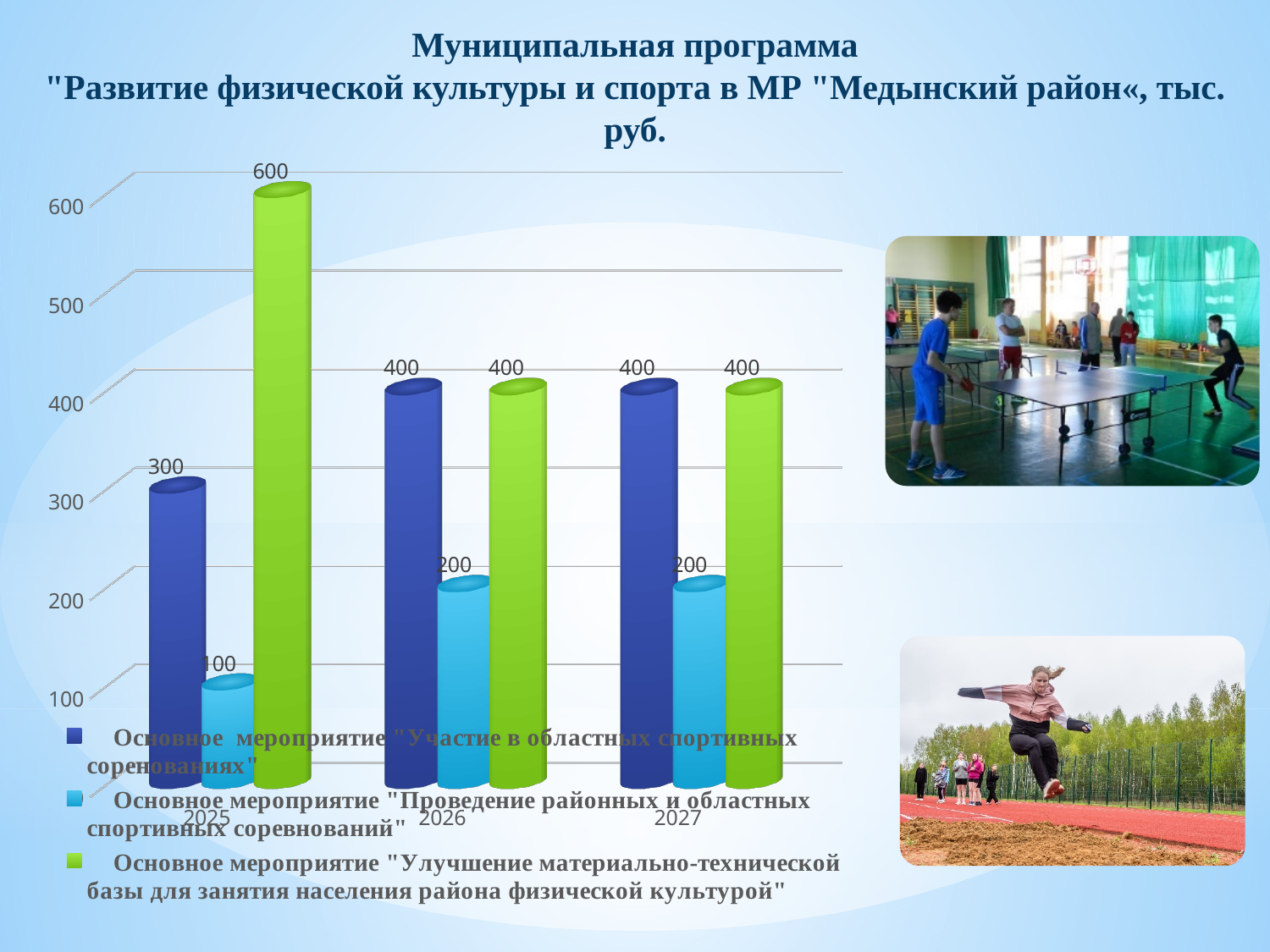
What is the value for 2025 for the series "Улучшение материально-технической базы для занятия населения района физической культурой"? 600 Which year has the highest value for the series "Улучшение материально-технической базы для занятия населения района физической культурой"? 2025 What is the value for 2027 for the series "Участие в областных спортивных соревнованиях"? 400 Which year has the lowest value for the series "Проведение районных и областных спортивных соревнований"? 2025 How many years are shown on the x axis of the chart? 3 What is the difference between the 2025 values of the series "Улучшение материально-технической базы..." and "Участие в областных спортивных соревнованиях"? 300 Does the value for the series "Участие в областных спортивных соревнованиях" rise or fall from 2025 to 2026? Rise How many series does the chart legend list? 3 What kind of chart is shown on the slide? Bar chart What is the value for 2026 for the series "Проведение районных и областных спортивных соревнований"? 200 In 2025, which series has the larger value: "Участие в областных спортивных соревнованиях" or "Проведение районных и областных спортивных соревнований"? Участие в областных спортивных соревнованиях What is the value for 2025 for the series "Участие в областных спортивных соревнованиях"? 300